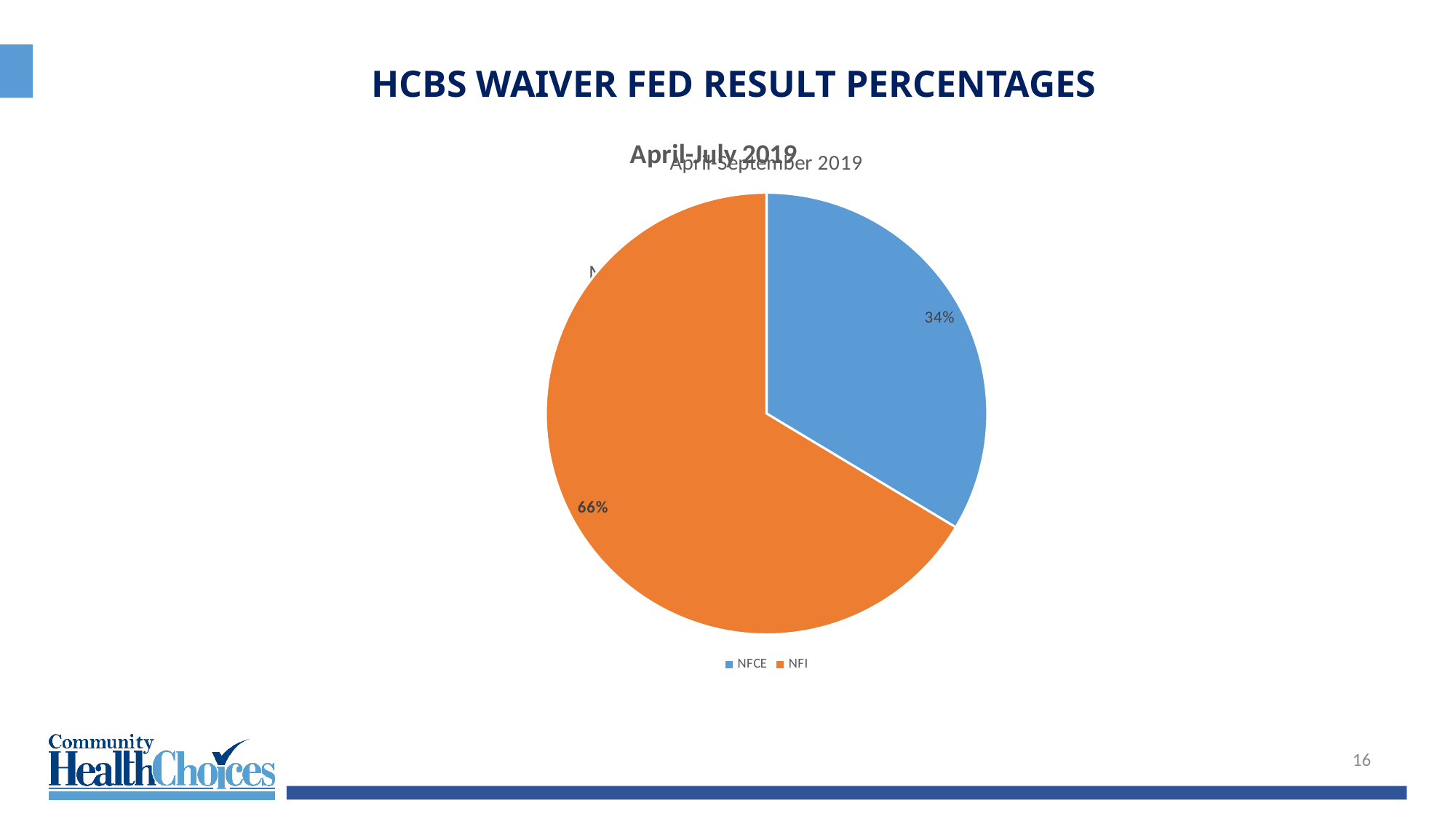
Which category has the largest share of the pie? NFI What kind of chart is shown on the slide? Pie chart Which category has the smallest share of the pie? NFCE What percentage of the pie does NFCE account for? 34% What is the slide title above the chart? HCBS WAIVER FED RESULT PERCENTAGES How many entries does the legend list? 2 Which is larger, the NFCE share or the NFI share? NFI What colour is the NFCE slice? Blue What is the difference in percentage points between the NFI and NFCE shares? 32 How many slices does the pie chart have? 2 What percentage of the pie does NFI account for? 66% What is the share of the pie for NFI? 66%